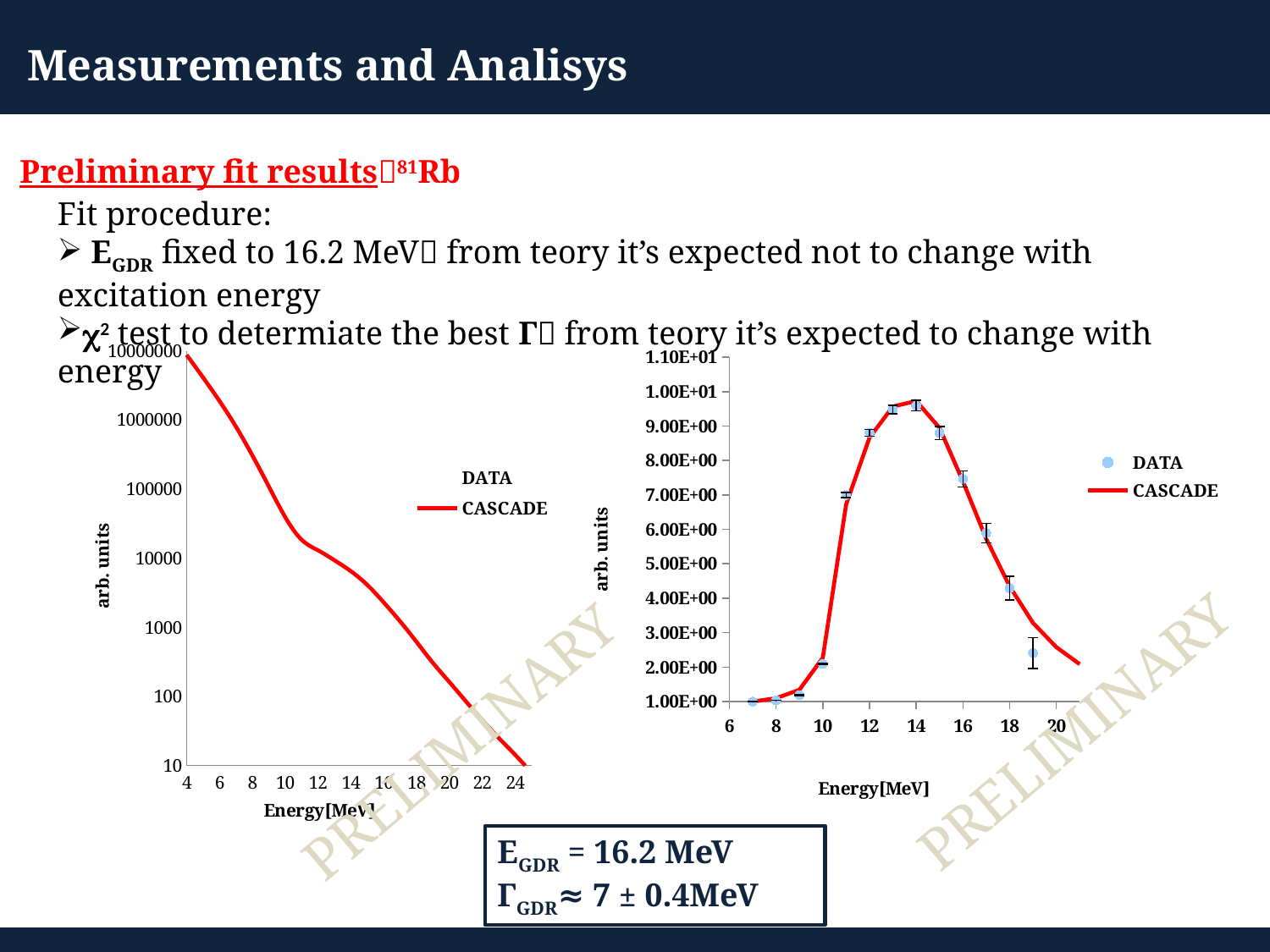
In the left chart, is the CASCADE value at 20 MeV greater or less than 1000? less How many DATA points are plotted in the right chart? 13 In the right chart, which is larger, the DATA value at 12 MeV or at 17 MeV? 12 MeV What is the x-axis label of the right chart? Energy[MeV] In the right chart, is the DATA value at 14 MeV greater or less than 9.00E+00? greater In the left chart, is the CASCADE value at 10 MeV greater or less than 10000? greater In the left chart, do the CASCADE values rise or fall as energy increases from 4 to 24 MeV? fall What are the legend entries of the left chart? DATA, CASCADE What kind of chart is the left chart? line chart How many series does the legend of the right chart list? 2